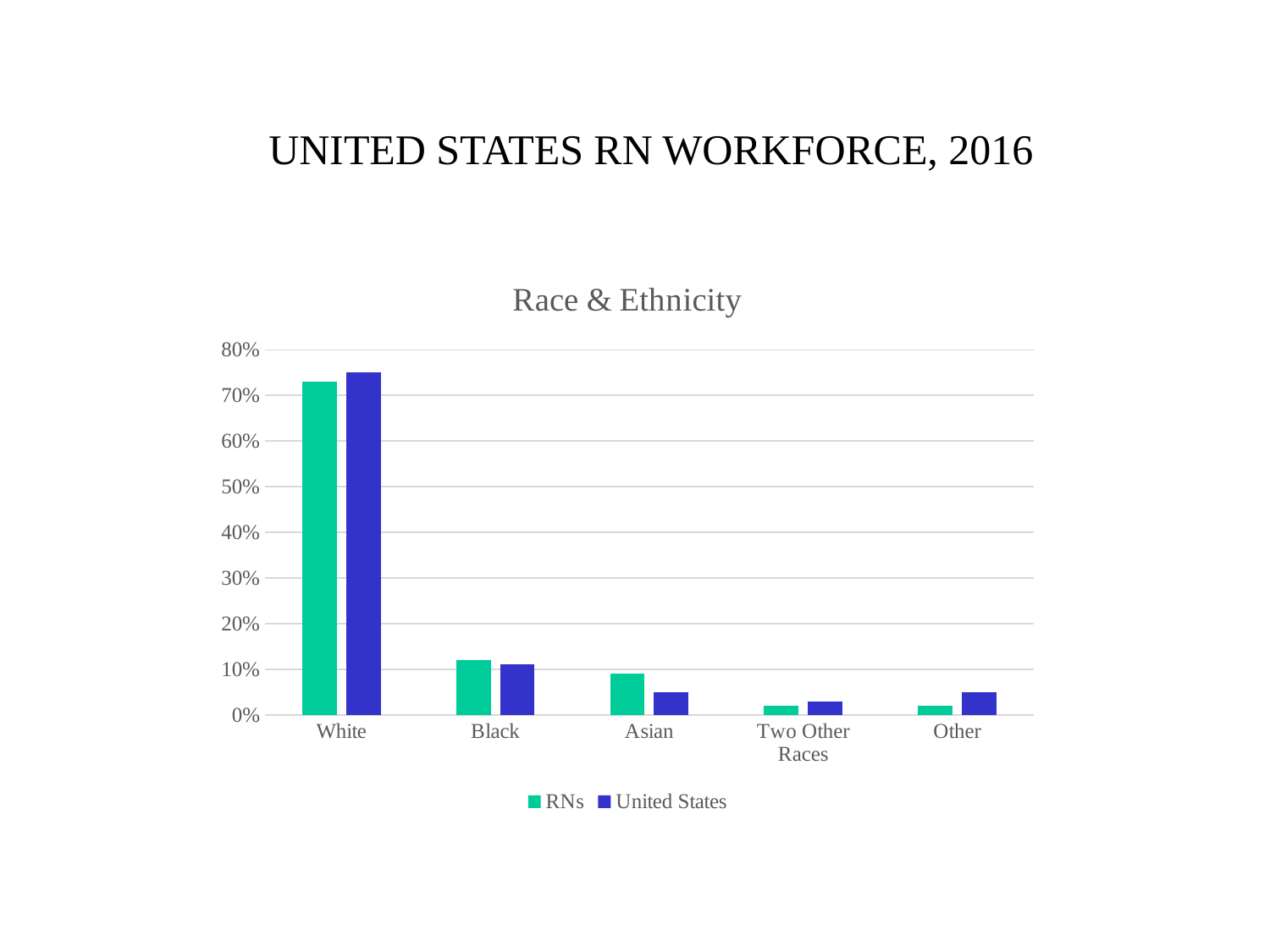
Which category has the highest value for United States? White Which category has the lowest value for United States? Two Other Races Is the value for White RNs greater or less than 70%? greater How many series does the legend list? 2 Is the United States value for Asian greater or less than 10%? less What kind of chart is shown on the slide? bar chart For the Asian category, which is larger: RNs or United States? RNs Is the value for Black RNs greater or less than 10%? greater Which category has the highest value for RNs? White How many race and ethnicity categories are shown on the x axis? 5 What is the title of the chart? Race & Ethnicity For the Other category, which is larger: RNs or United States? United States